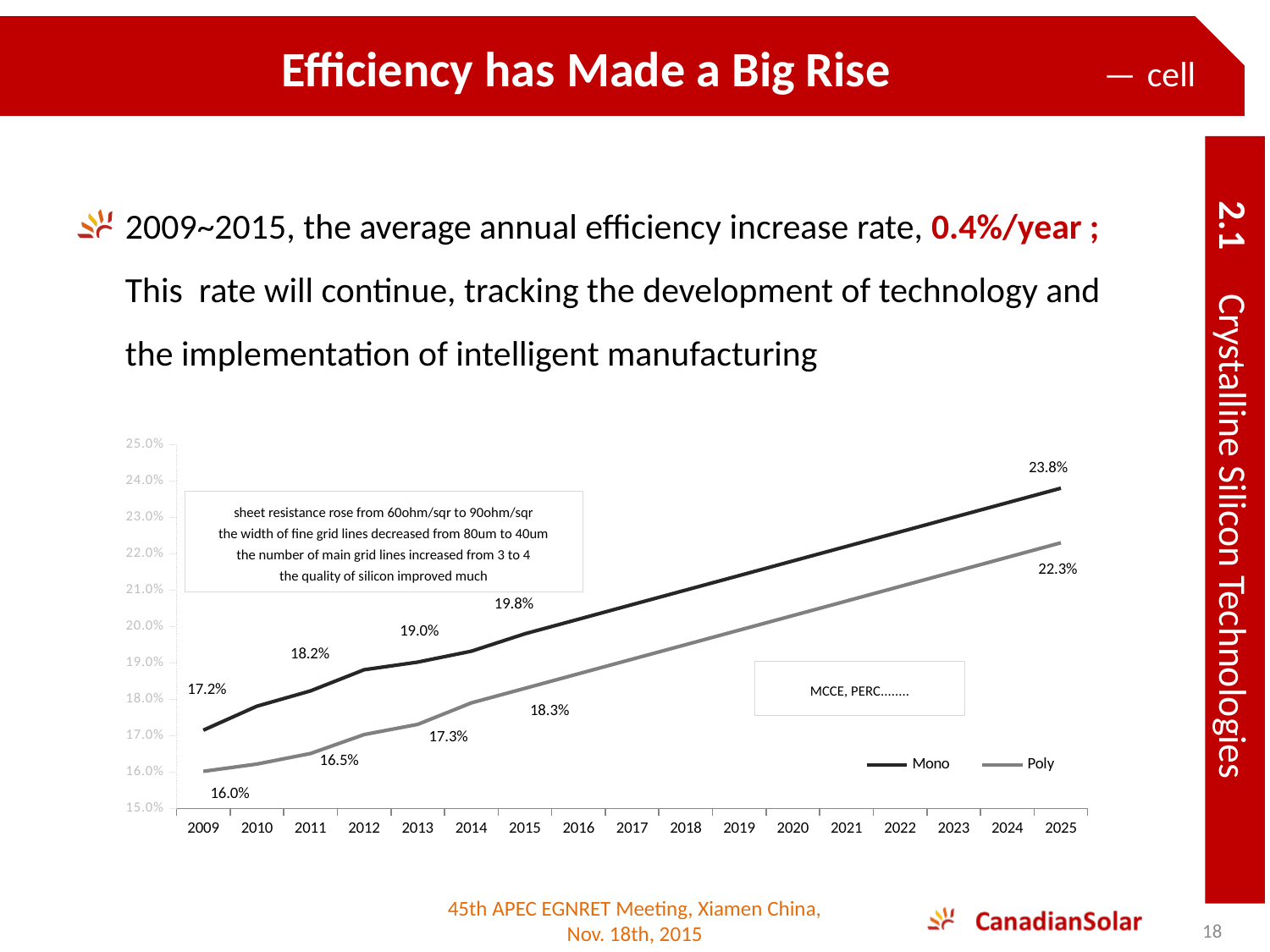
What is the Poly efficiency value labelled for 2025? 22.3% What is the Mono efficiency value labelled for 2025? 23.8% How many series does the chart legend list? 2 What type of chart is shown on the slide? line chart What are the two series named in the chart legend? Mono and Poly Do the Mono and Poly values rise or fall from 2009 to 2025? rise What is the difference between the Mono and Poly values labelled for 2025? 1.5% What is the Poly efficiency value labelled for 2009? 16.0% What is the Mono efficiency value labelled for 2009? 17.2% How many years are shown on the x axis of the chart? 17 Which series is higher in 2013, Mono or Poly? Mono What is the Mono efficiency value labelled for 2015? 19.8%